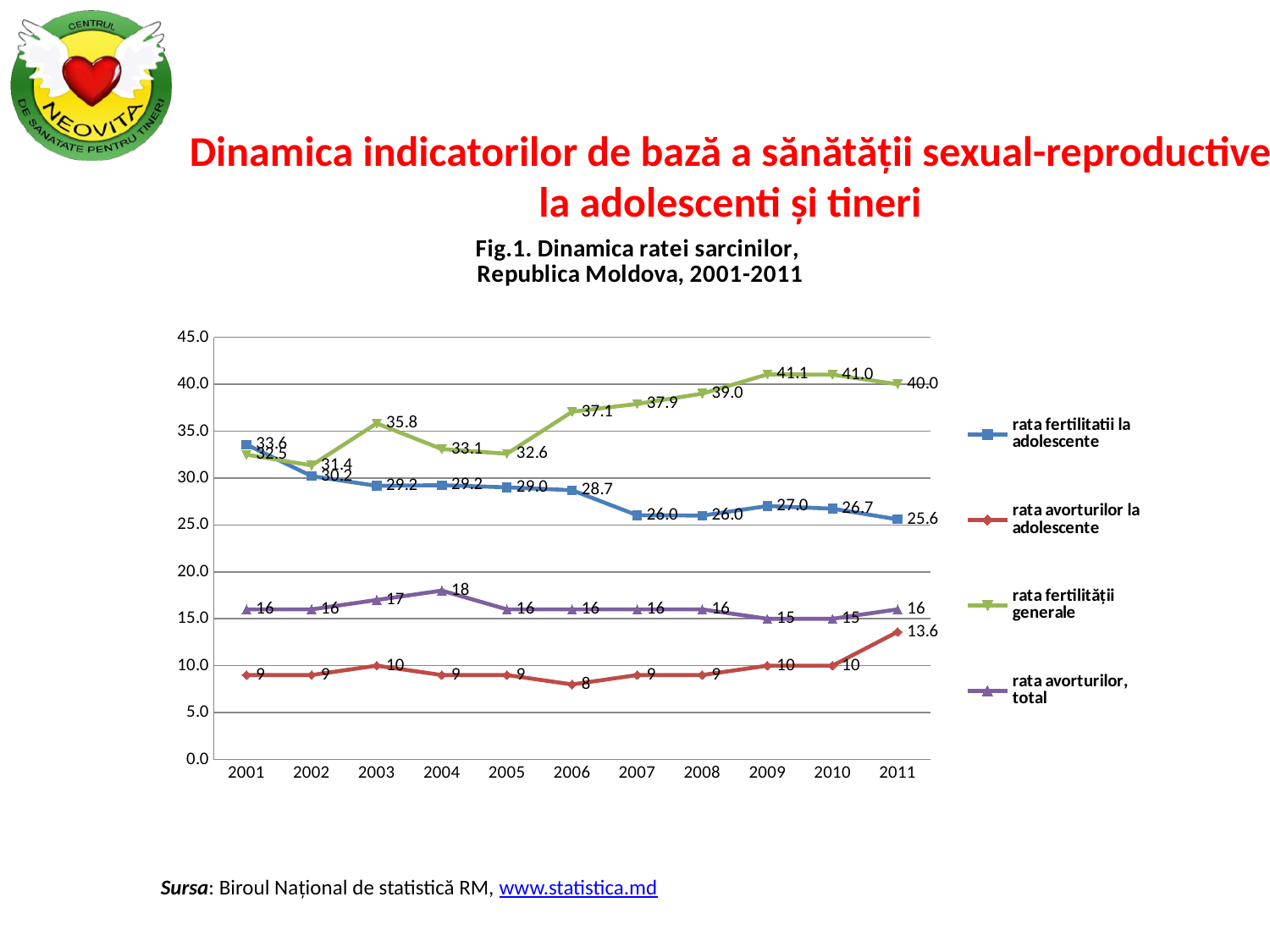
How many years are shown on the x axis? 11 What is the value of 'rata fertilitatii la adolescente' in 2001? 33.6 What is the difference between 'rata fertilitatii la adolescente' in 2001 and in 2011? 8.0 What kind of chart is shown? line chart What is the value of 'rata avorturilor la adolescente' in 2011? 13.6 Which is larger in 2001: 'rata fertilitatii la adolescente' or 'rata fertilității generale'? rata fertilitatii la adolescente How many series does the legend list? 4 Does 'rata fertilitatii la adolescente' generally rise or fall from 2001 to 2011? fall What is the value of 'rata avorturilor, total' in 2004? 18 What is the value of 'rata fertilității generale' in 2009? 41.1 In which year is 'rata fertilității generale' highest? 2009 In which year is 'rata fertilitatii la adolescente' lowest? 2011